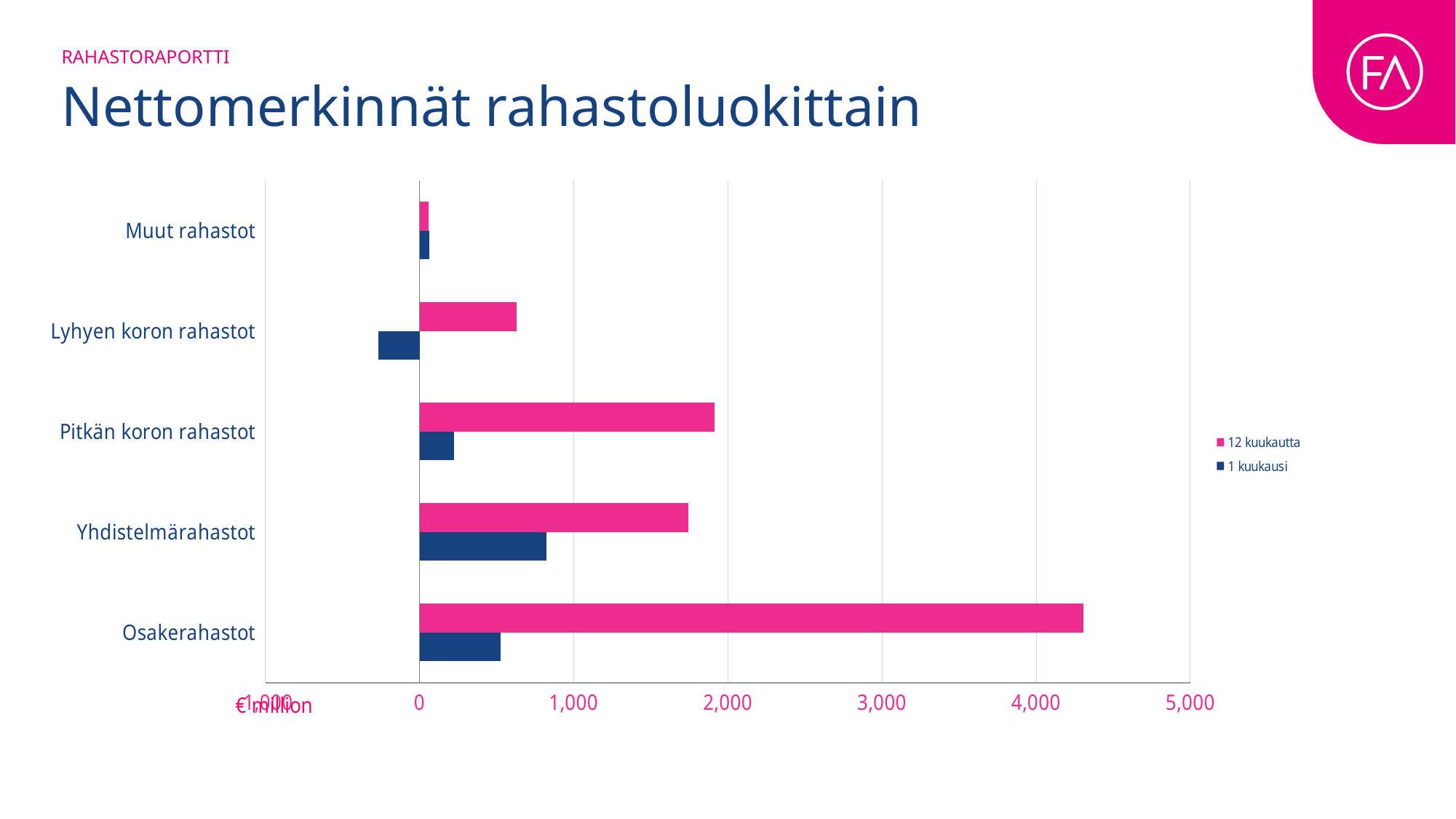
Which colour represents the 12 kuukautta series in the legend? Pink Which category has the lowest value for the 1 kuukausi series? Lyhyen koron rahastot For the 1 kuukausi series, which is larger: Osakerahastot or Yhdistelmärahastot? Yhdistelmärahastot Which category has the highest value for the 12 kuukautta series? Osakerahastot Which category has the highest value for the 1 kuukausi series? Yhdistelmärahastot Is the 1 kuukausi value for Lyhyen koron rahastot greater or less than 0? less How many fund categories are shown on the chart? 5 Is the 12 kuukautta value for Yhdistelmärahastot greater or less than 2,000? less Which category has the lowest value for the 12 kuukautta series? Muut rahastot What kind of chart is shown on the slide? Bar chart How many series does the legend list? 2 Is the 12 kuukautta value for Osakerahastot greater or less than 4,000? greater